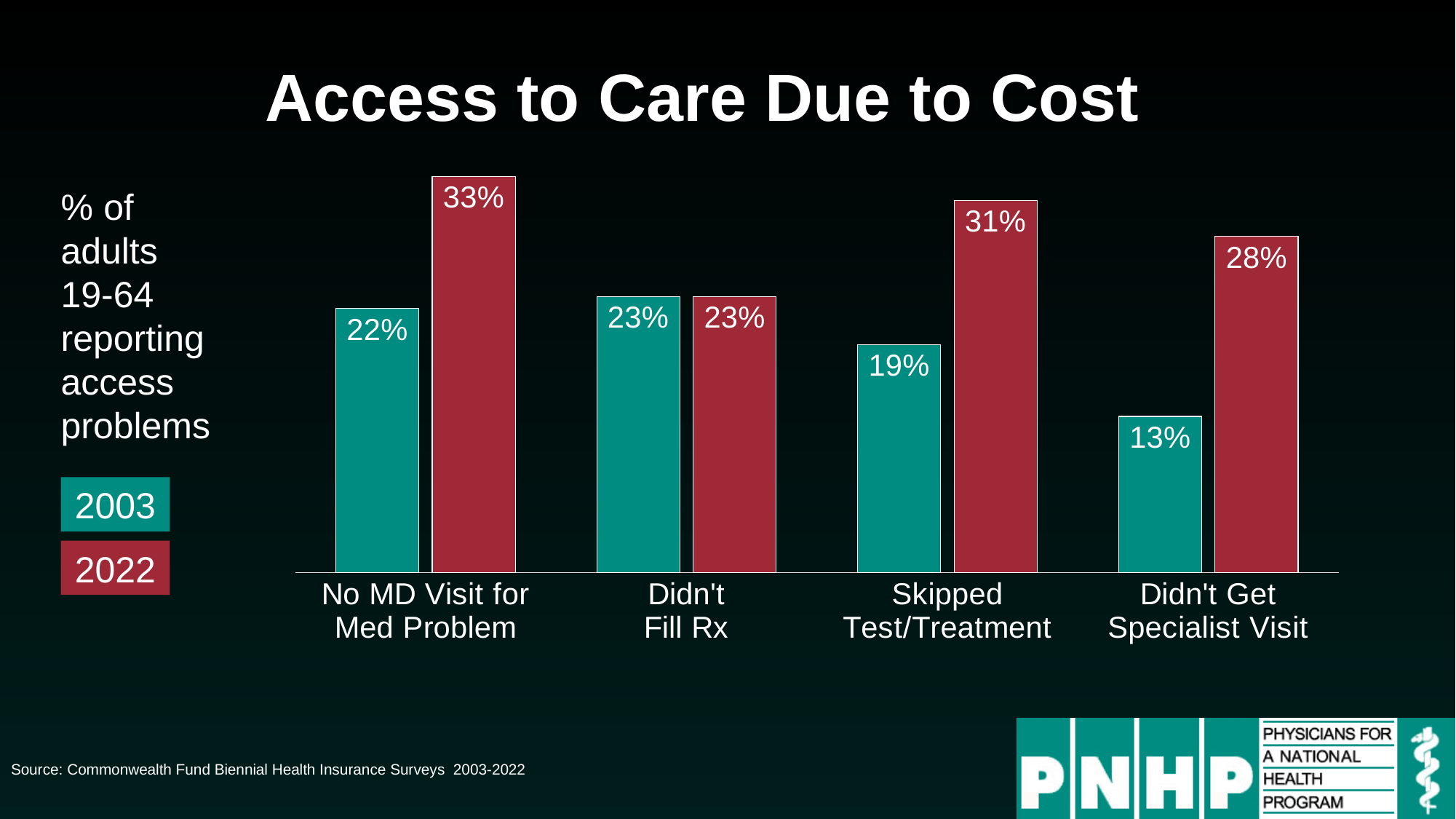
How many categories are shown on the x axis? 4 Which category has the highest 2022 value? No MD Visit for Med Problem What is the 2022 value for Didn't Fill Rx? 23% What is the 2003 value for Skipped Test/Treatment? 19% What is the title of the chart? Access to Care Due to Cost What is the 2003 value for Didn't Get Specialist Visit? 13% What is the difference between the 2022 and 2003 values for Didn't Get Specialist Visit? 15% Which category has the lowest 2003 value? Didn't Get Specialist Visit What is the 2022 value for No MD Visit for Med Problem? 33% What kind of chart is shown on the slide? Bar chart How many series does the legend list? 2 Which is larger: the 2022 value for Skipped Test/Treatment or the 2022 value for Didn't Get Specialist Visit? Skipped Test/Treatment